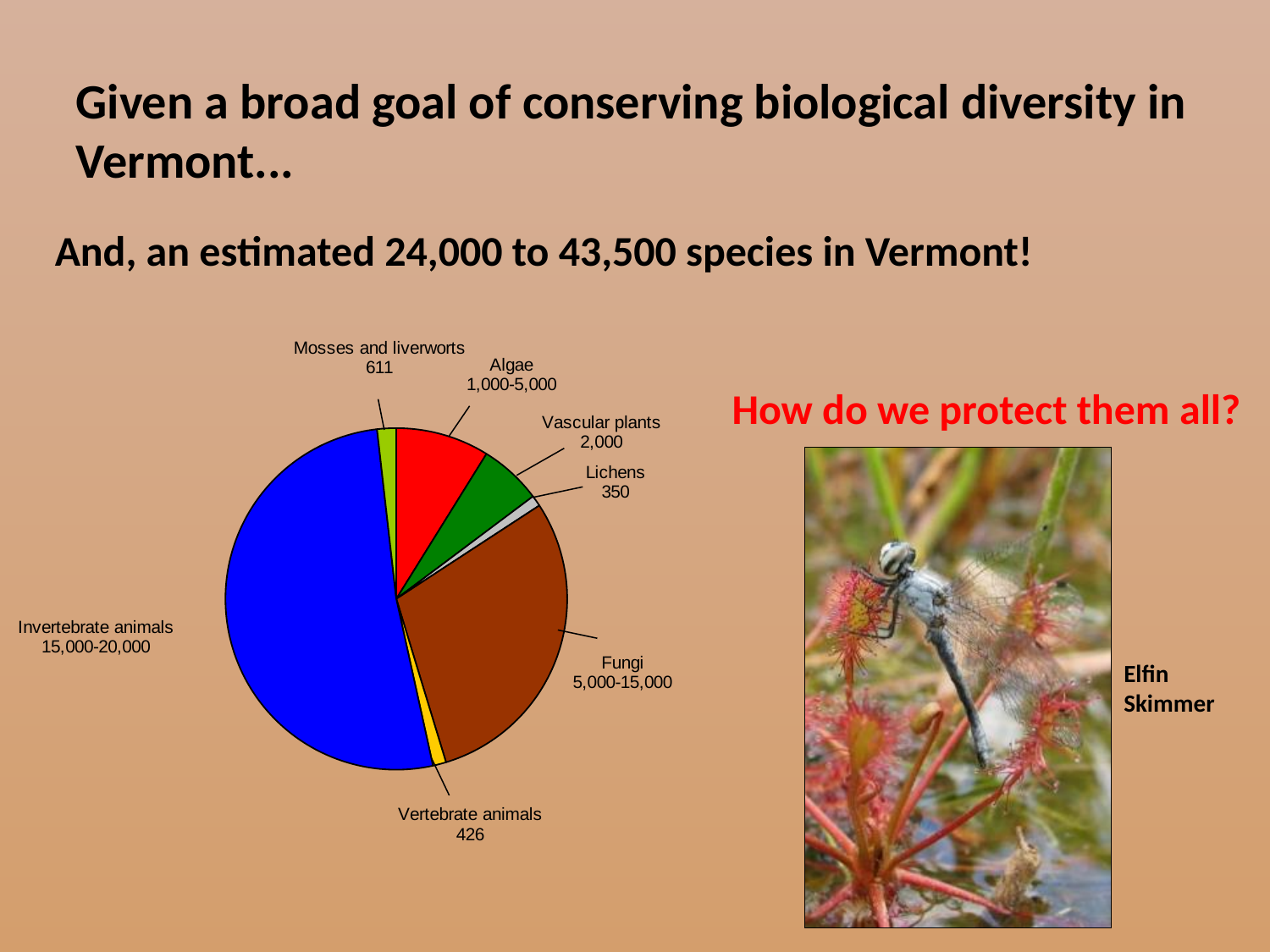
What range is shown for Invertebrate animals? 15,000-20,000 What value is shown for Vertebrate animals? 426 What is the difference between the values for Vascular plants and Mosses and liverworts? 1,389 What colour is the Invertebrate animals slice? blue What value is shown for Lichens? 350 What value is shown for Mosses and liverworts? 611 Which is larger, the slice for Fungi or the slice for Vascular plants? Fungi Which category has the largest slice of the pie? Invertebrate animals What value is shown for Vascular plants? 2,000 What range is shown for Fungi? 5,000-15,000 What kind of chart is shown on the slide? pie chart How many categories does the pie chart show? 7